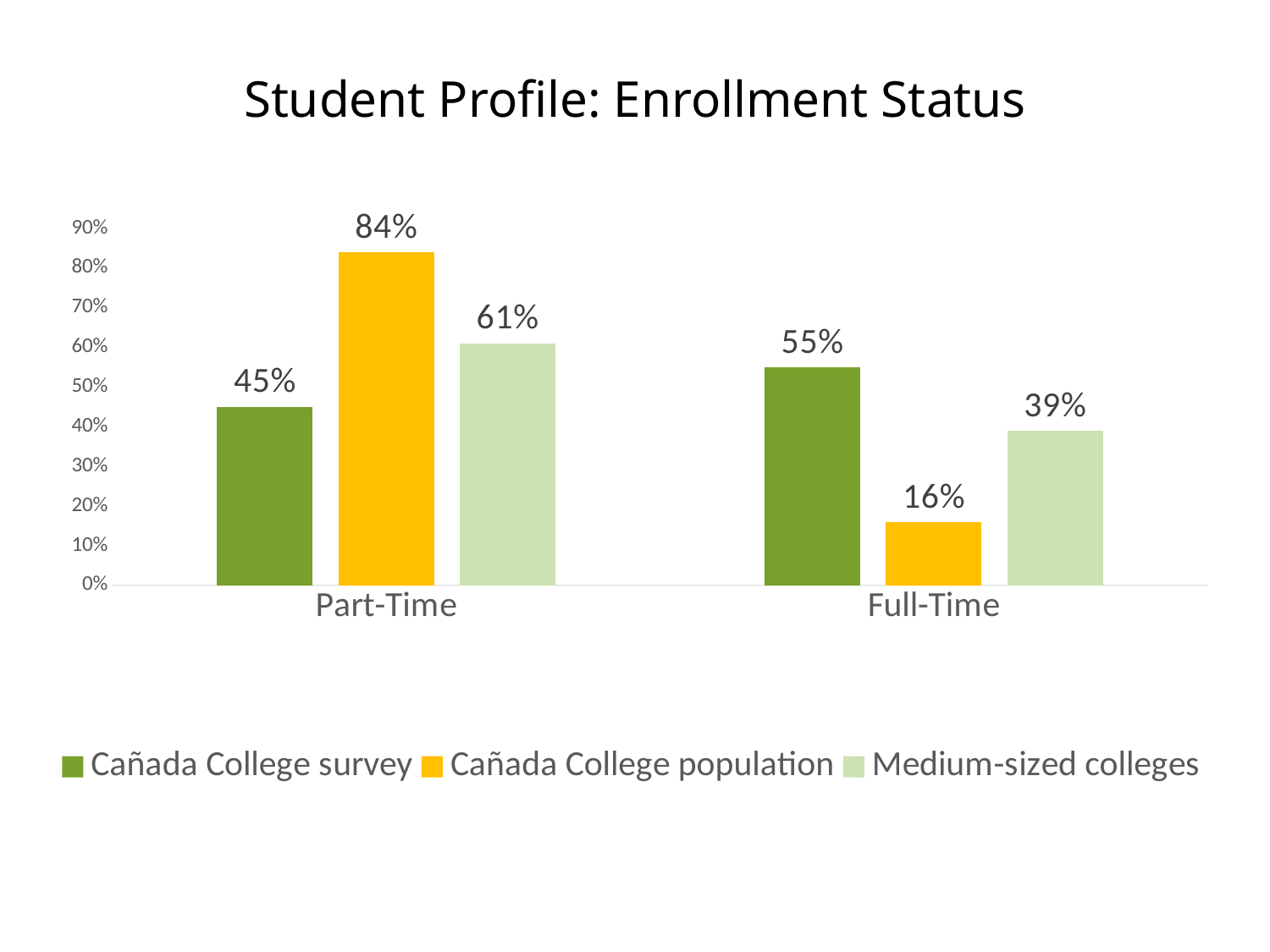
What kind of chart is shown on the slide? Bar chart What is the title of the chart? Student Profile: Enrollment Status What is the Full-Time value for the Cañada College survey series? 55% What is the difference between the Part-Time and Full-Time values for the Cañada College population series? 68% Which series has the lowest Full-Time value? Cañada College population Which is larger: the Full-Time value for Cañada College survey or the Part-Time value for Medium-sized colleges? Part-Time value for Medium-sized colleges How many categories are shown on the x axis? 2 How many series does the legend list? 3 What is the Part-Time value for the Cañada College population series? 84% What is the difference between the Medium-sized colleges Part-Time value and the Cañada College survey Part-Time value? 16% What is the Full-Time value for Medium-sized colleges? 39% Which series has the highest Part-Time value? Cañada College population